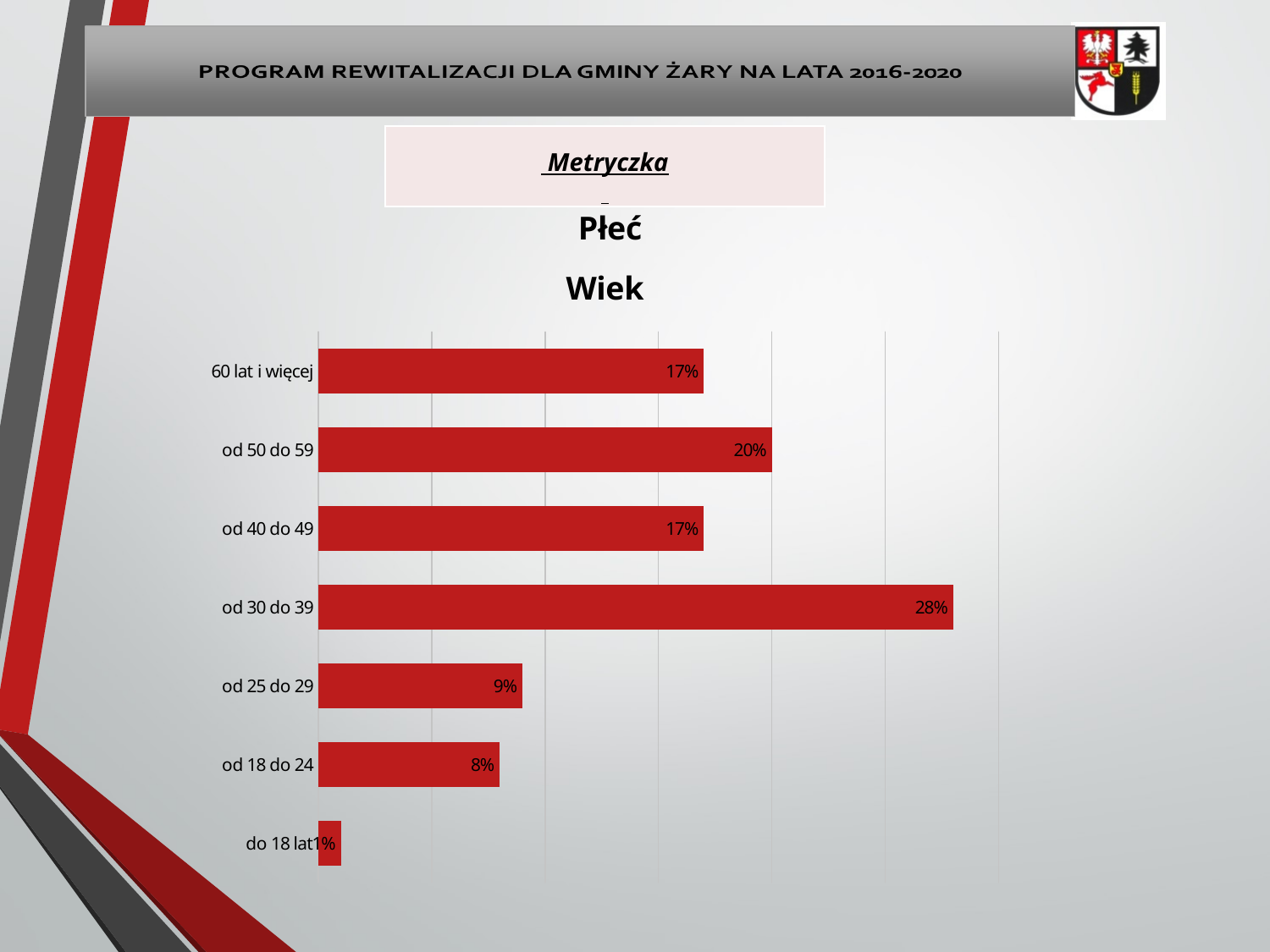
What is the value for the 'od 18 do 24' age group? 8% How many age groups are shown in the chart? 7 Which is larger, the value for 'od 50 do 59' or the value for 'od 40 do 49'? od 50 do 59 Which age group has the lowest value? do 18 lat What is the title of the chart? Wiek What is the value for the 'od 30 do 39' age group? 28% What is the difference between the values for 'od 25 do 29' and 'od 18 do 24'? 1% What kind of chart is shown on the slide? bar chart Which age group has the highest value? od 30 do 39 What is the value for the 'do 18 lat' age group? 1% What is the value for the 'od 50 do 59' age group? 20% What is the difference between the values for 'od 30 do 39' and 'od 50 do 59'? 8%